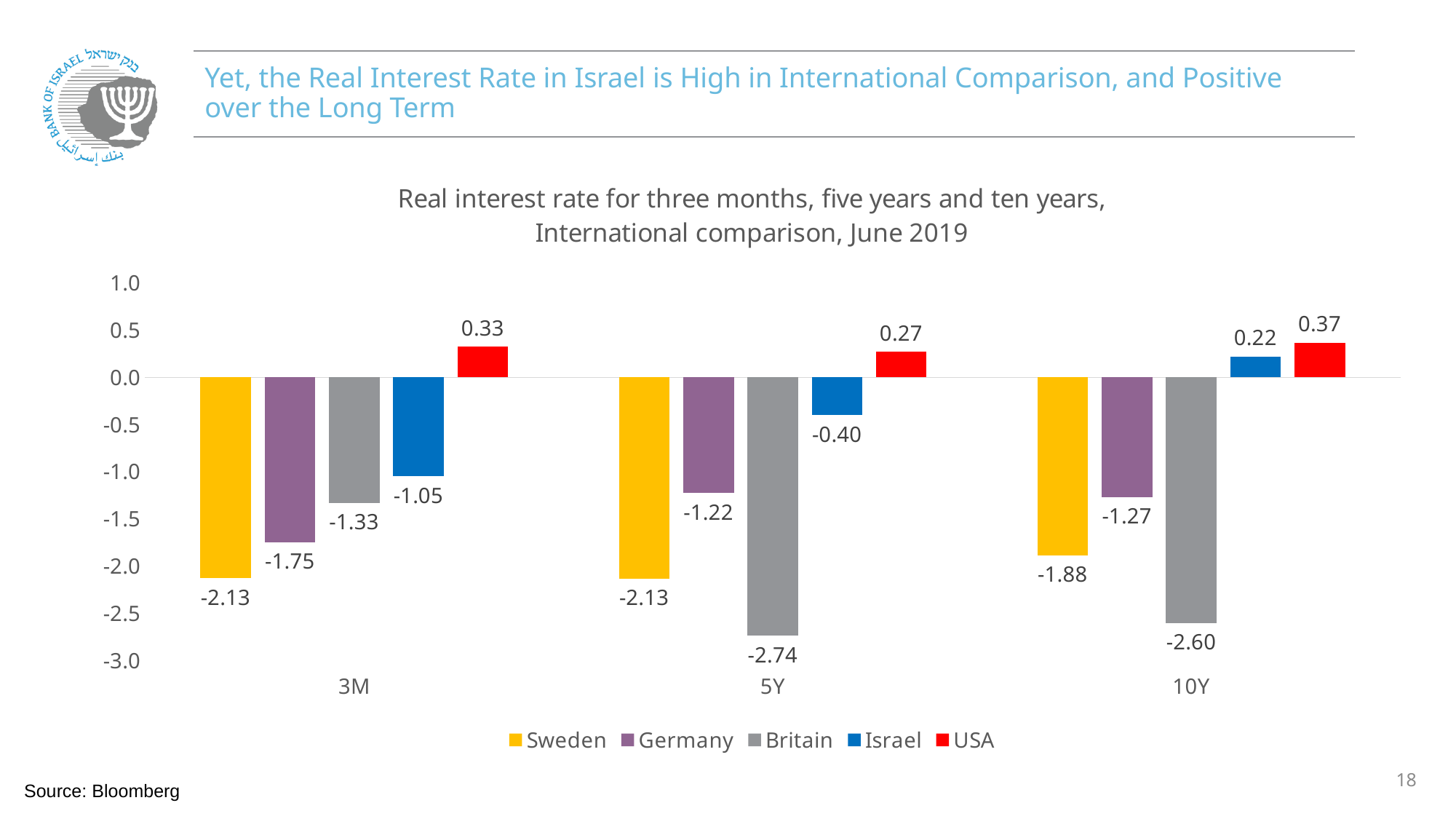
Which country has the highest real interest rate at 5Y? USA What is the real interest rate for the USA at 10Y? 0.37 Which colour represents Israel in the chart? Blue Which country has the lowest real interest rate at 10Y? Britain How many series does the legend list? 5 How many maturity categories are shown on the x axis? 3 Which is higher at 3M, the real interest rate for Sweden or for Germany? Germany What is the difference between the USA and Israel real interest rates at 10Y? 0.15 What is the real interest rate for Germany at 10Y? -1.27 What is the real interest rate for Britain at 5Y? -2.74 What is the real interest rate for Israel at 3M? -1.05 What kind of chart is shown on the slide? Bar chart